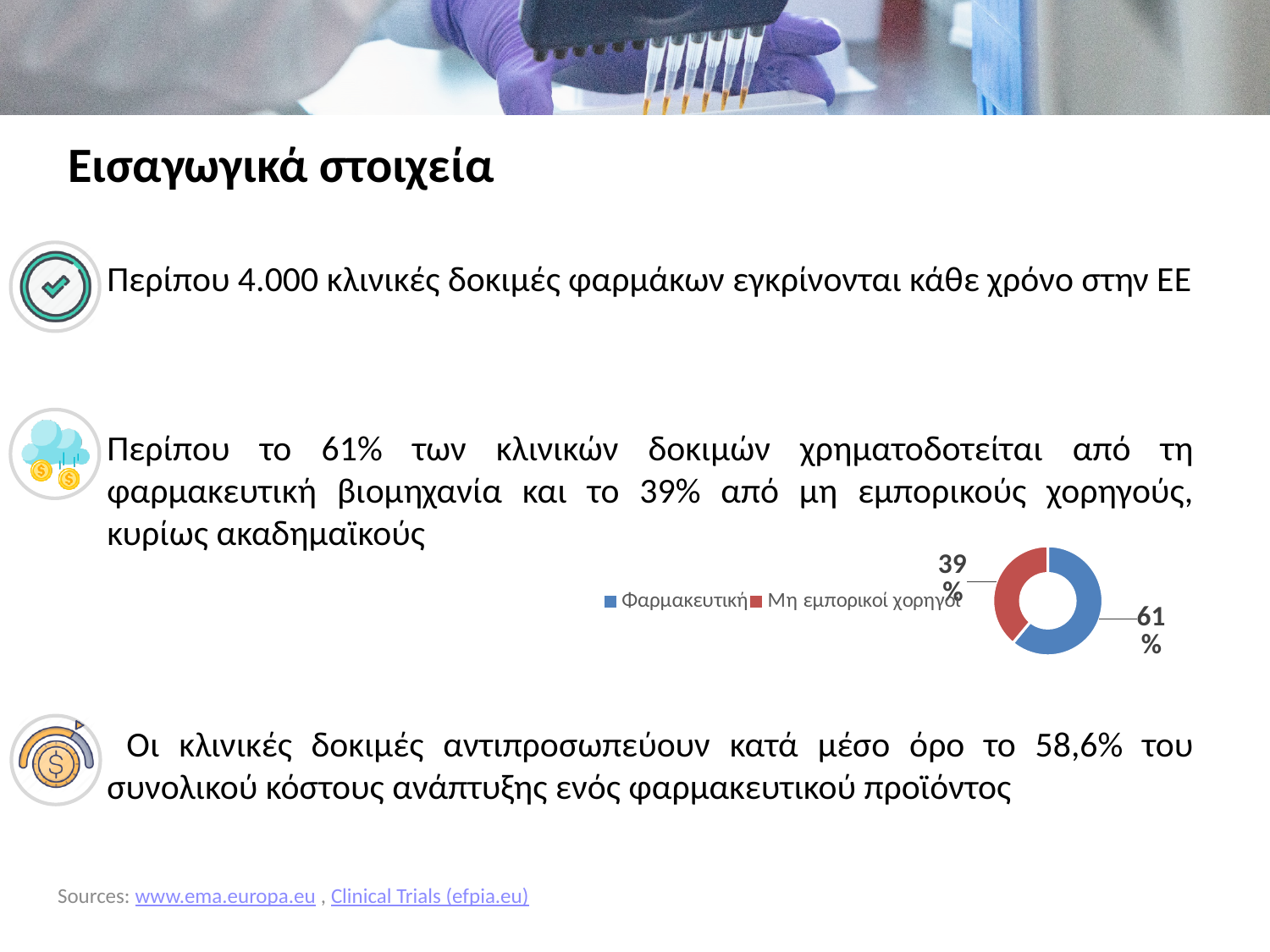
Which is larger in the doughnut chart, Φαρμακευτική or Μη εμπορικοί χορηγοί? Φαρμακευτική Which category has the largest share in the doughnut chart? Φαρμακευτική What share of the doughnut chart does Μη εμπορικοί χορηγοί represent? 39% What is the value for Φαρμακευτική in the doughnut chart? 61% What colour is the Φαρμακευτική slice in the doughnut chart? Blue What is the difference between the shares of Φαρμακευτική and Μη εμπορικοί χορηγοί? 22% What colour is the Μη εμπορικοί χορηγοί slice in the doughnut chart? Red What is the value for Μη εμπορικοί χορηγοί in the doughnut chart? 39% How many entries does the legend of the doughnut chart list? 2 What kind of chart is shown on the slide? Doughnut chart How many categories does the doughnut chart show? 2 Which category has the smallest share in the doughnut chart? Μη εμπορικοί χορηγοί